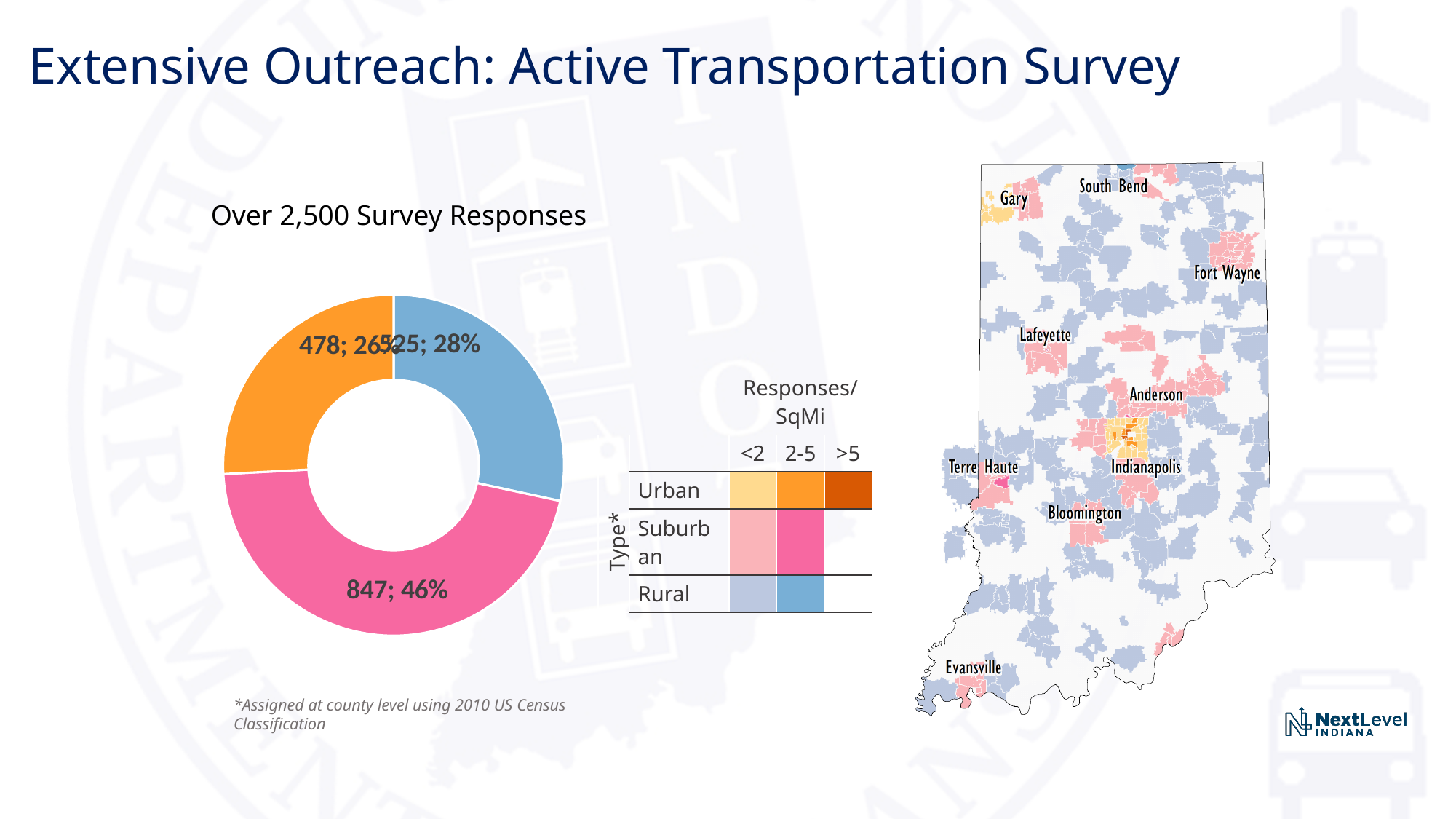
Which has more responses, the Rural slice or the Urban slice? Rural What share of responses does the Suburban slice represent? 46% What is the difference in responses between the Suburban and Urban slices? 369 What share of responses does the Urban slice represent? 26% How many slices does the donut chart have? 3 What kind of chart is shown on the left of the slide? Donut (pie) chart Which type has the smallest share of survey responses? Urban How many survey responses does the blue (Rural) slice represent? 525 Which type has the largest share of survey responses? Suburban How many survey responses does the pink (Suburban) slice represent? 847 What is the title above the donut chart? Over 2,500 Survey Responses How many survey responses does the orange (Urban) slice represent? 478